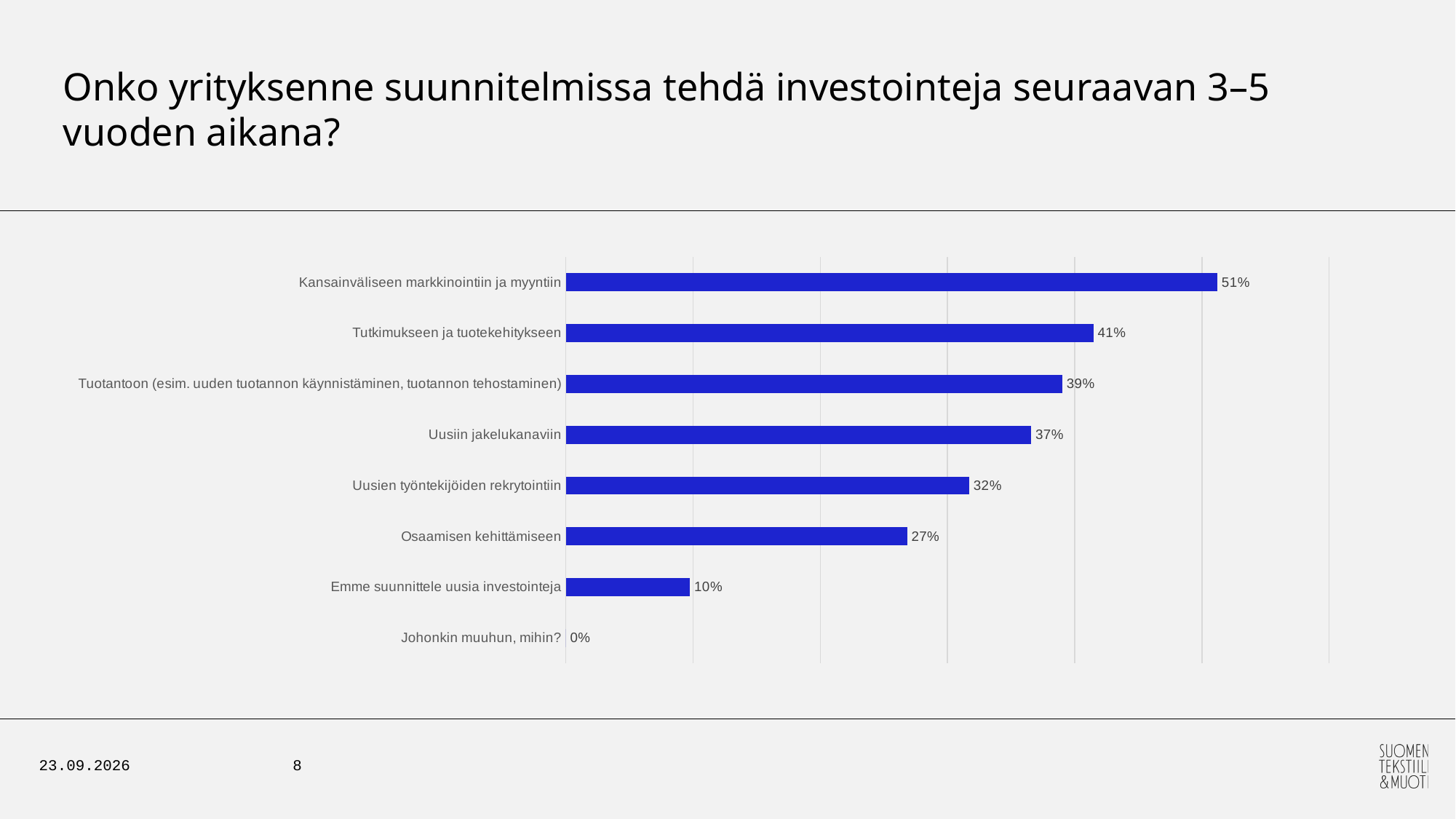
Which is larger, Uusiin jakelukanaviin or Uusien työntekijöiden rekrytointiin? Uusiin jakelukanaviin Which category has the lowest value? Johonkin muuhun, mihin? Which category has the highest value? Kansainväliseen markkinointiin ja myyntiin What is the difference between Tutkimukseen ja tuotekehitykseen and Osaamisen kehittämiseen? 14% What is the value for Uusien työntekijöiden rekrytointiin? 32% What is the difference between Kansainväliseen markkinointiin ja myyntiin and Emme suunnittele uusia investointeja? 41% What colour are the bars in the chart? Blue What kind of chart is shown on the slide? Bar chart What is the value for Johonkin muuhun, mihin? 0% What is the value for Kansainväliseen markkinointiin ja myyntiin? 51% What is the value for Emme suunnittele uusia investointeja? 10% How many categories are shown in the chart? 8